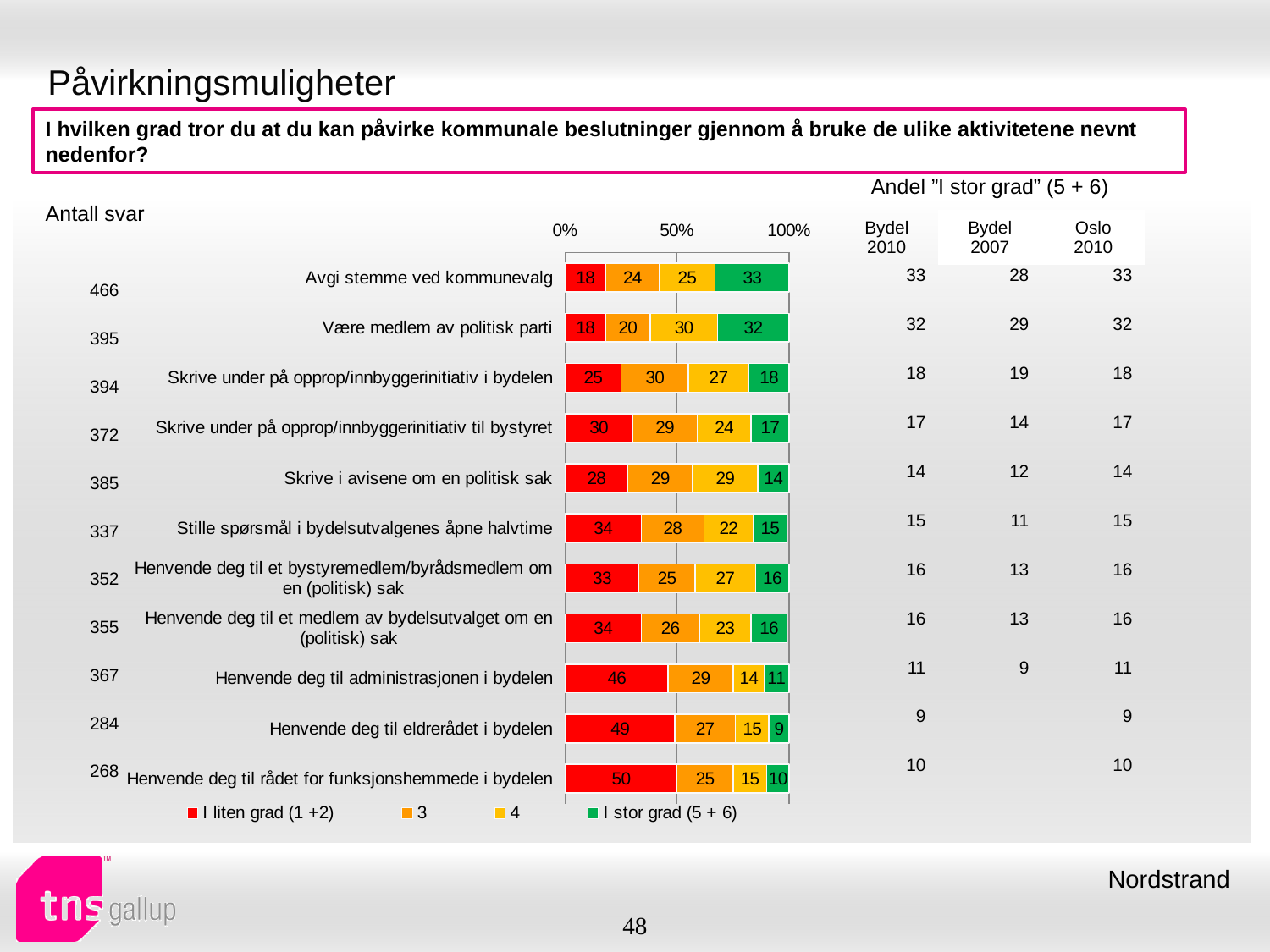
What is the value of series "3" for "Skrive under på opprop/innbyggerinitiativ i bydelen"? 30 What is the value of "I stor grad (5 + 6)" for "Avgi stemme ved kommunevalg"? 33 What is the value of series "4" for "Være medlem av politisk parti"? 30 What is the value of "I liten grad (1 +2)" for "Henvende deg til administrasjonen i bydelen"? 46 Which category has the lowest value for "I stor grad (5 + 6)"? Henvende deg til eldrerådet i bydelen What is the label of the first (red) series in the chart legend? I liten grad (1 +2) Which category has the highest value for "I liten grad (1 +2)"? Henvende deg til rådet for funksjonshemmede i bydelen How many categories (activities) are plotted in the chart? 11 What is the difference between the "I liten grad (1 +2)" values for "Henvende deg til eldrerådet i bydelen" and "Avgi stemme ved kommunevalg"? 31 Which is larger: the "I stor grad (5 + 6)" value for "Skrive i avisene om en politisk sak" or for "Skrive under på opprop/innbyggerinitiativ til bystyret"? Skrive under på opprop/innbyggerinitiativ til bystyret What type of chart is shown on the slide? Stacked bar chart How many series does the chart legend list? 4